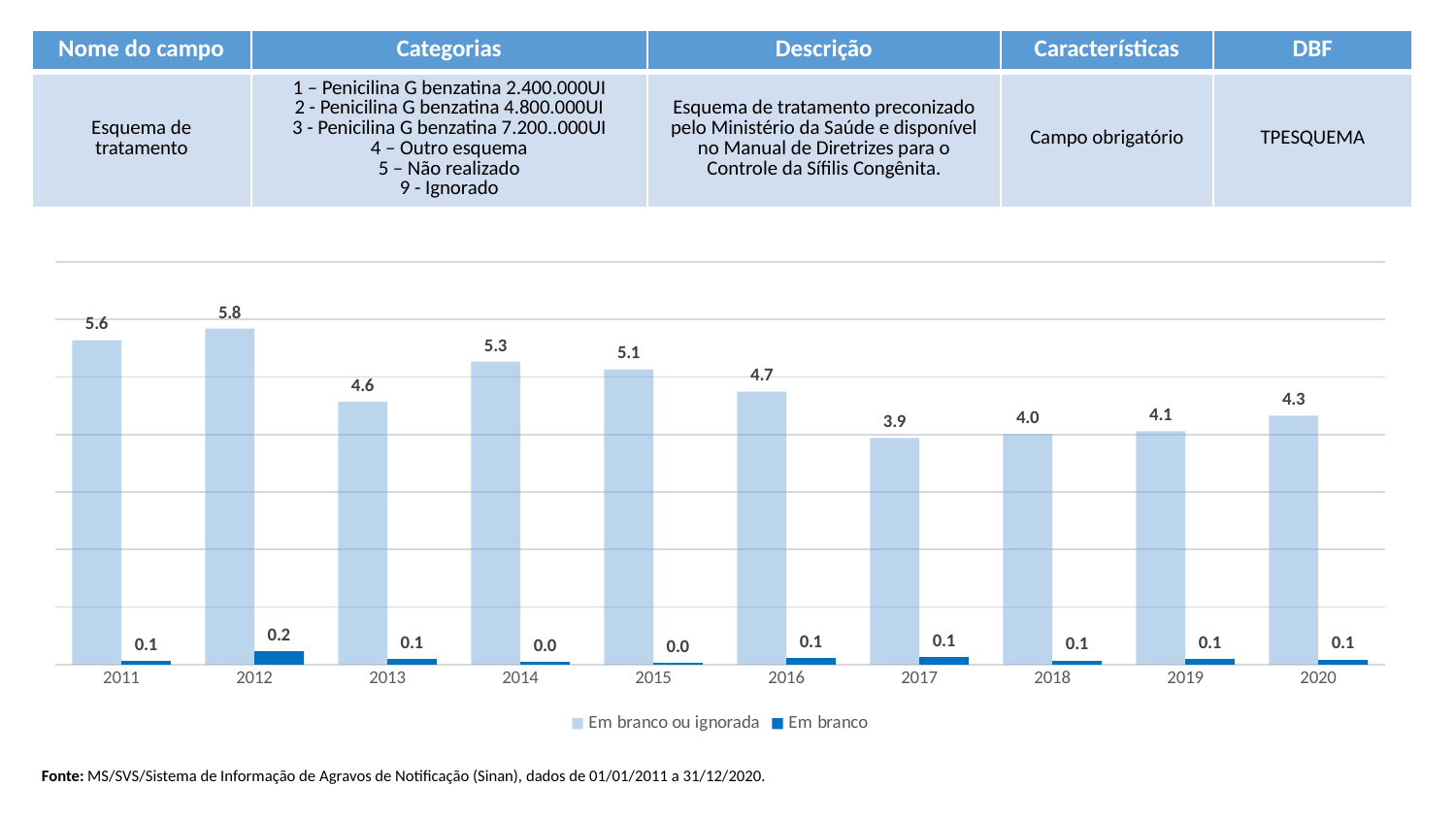
What is the value for "Em branco" in 2014? 0.0 How many years are shown on the x axis of the chart? 10 What is the value for "Em branco" in 2012? 0.2 What is the value for "Em branco ou ignorada" in 2017? 3.9 Which year has the highest value for "Em branco ou ignorada"? 2012 How many series does the chart legend list? 2 What kind of chart is shown on the slide? Bar chart Which is larger, the "Em branco ou ignorada" value for 2014 or for 2016? 2014 What is the value for "Em branco ou ignorada" in 2012? 5.8 What is the difference between the "Em branco ou ignorada" values for 2011 and 2020? 1.3 Does the "Em branco ou ignorada" series rise or fall from 2012 to 2017? Fall Which year has the lowest value for "Em branco ou ignorada"? 2017